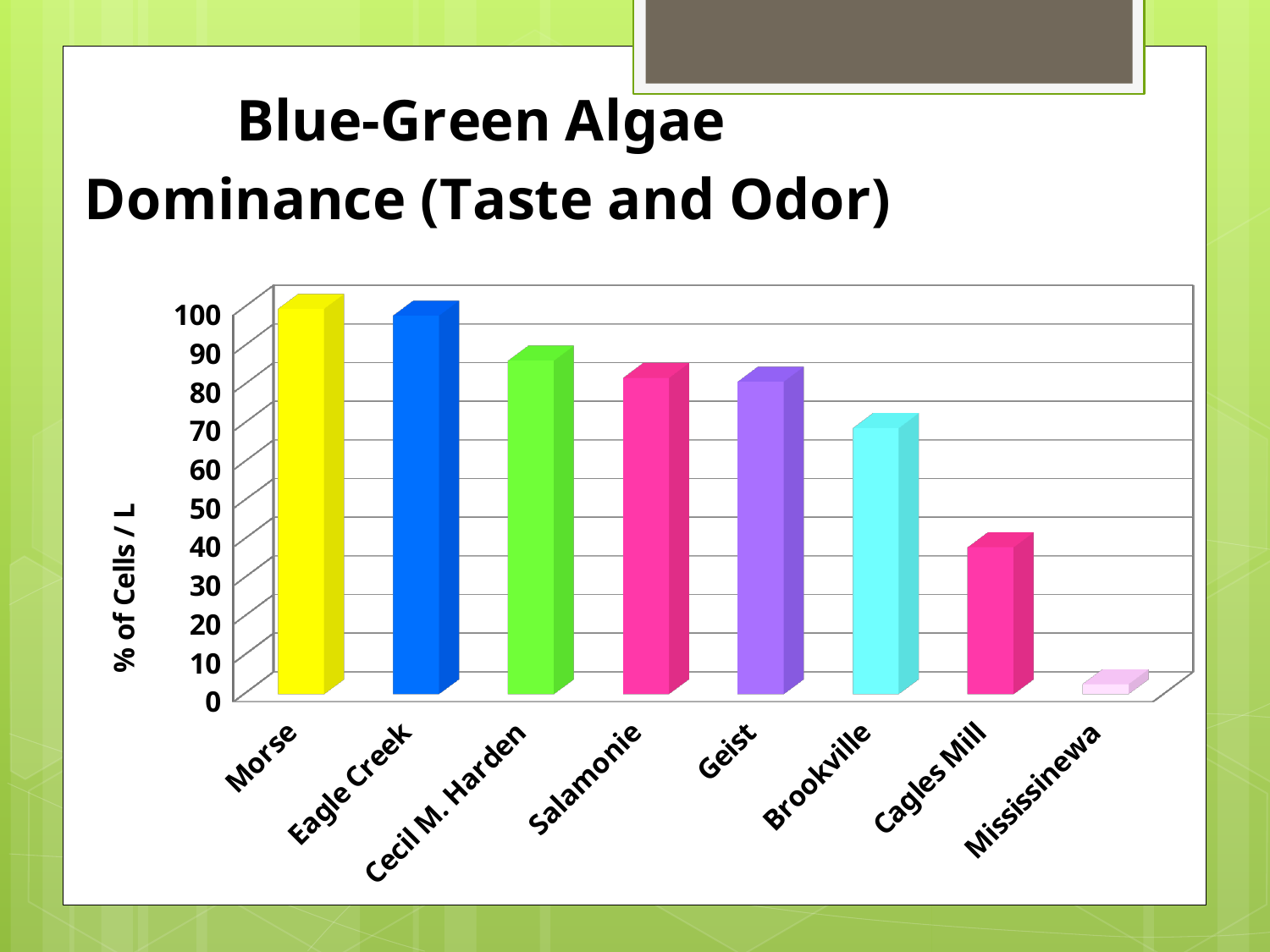
Which reservoir has the lowest % of Cells / L in the chart? Mississinewa Which reservoir has the highest % of Cells / L in the chart? Morse Is the value for Cecil M. Harden greater or less than 80? greater Which has a larger % of Cells / L, Eagle Creek or Salamonie? Eagle Creek How many reservoirs (categories) are shown on the x axis of the chart? 8 Is the value for Mississinewa greater or less than 10? less Is the value for Cagles Mill greater or less than 50? less What is the label on the vertical axis of the chart? % of Cells / L What kind of chart is shown on the slide? bar chart Which has a larger % of Cells / L, Brookville or Cagles Mill? Brookville Do the bar values rise or fall moving from left to right along the x axis? fall